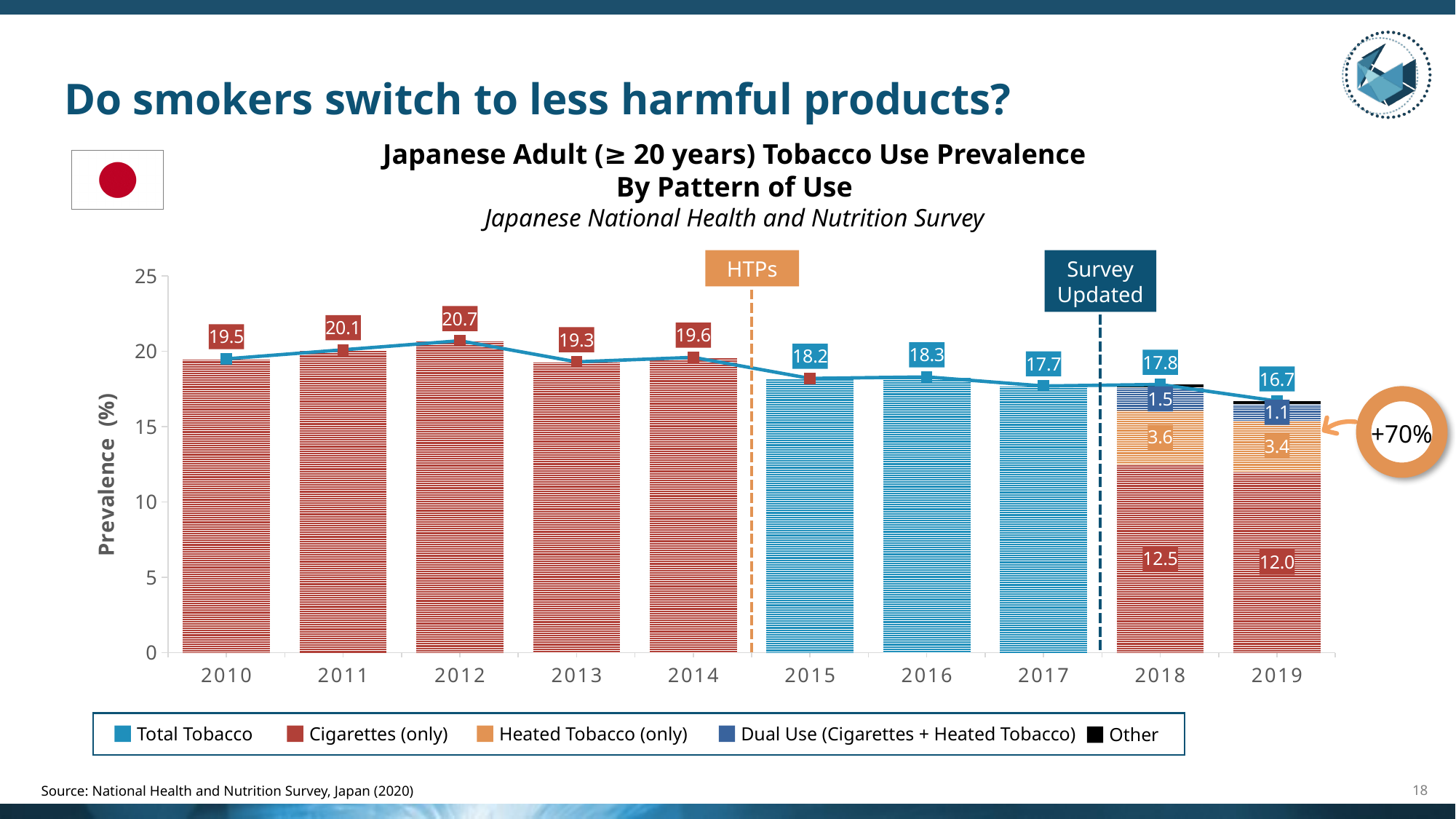
Which year has the highest Total Tobacco prevalence? 2012 Overall, does the Total Tobacco prevalence rise or fall from 2012 to 2019? fall What is the Dual Use (Cigarettes + Heated Tobacco) value for 2018? 1.5 What is the Total Tobacco prevalence value for 2012? 20.7 What label is shown on the orange dashed vertical line between 2014 and 2015? HTPs What is the difference between the Total Tobacco prevalence in 2010 and in 2019? 2.8 How many series does the legend list? 5 Which year has the lowest Total Tobacco prevalence? 2019 Which year has the higher Total Tobacco prevalence, 2011 or 2017? 2011 What is the Cigarettes (only) prevalence value for 2018? 12.5 How many years are shown on the x axis? 10 What is the Heated Tobacco (only) prevalence value for 2019? 3.4